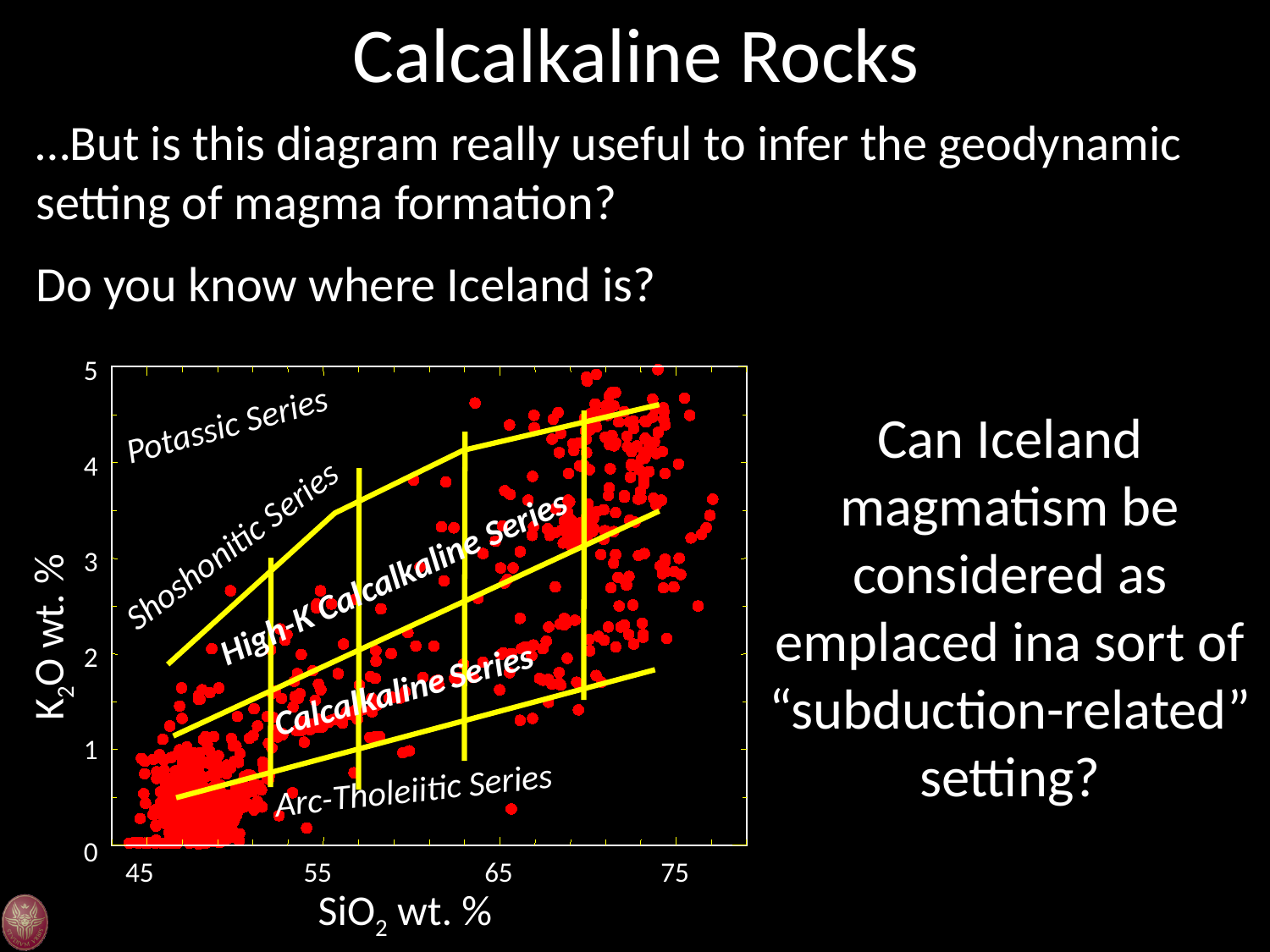
How many named series fields are labelled on the chart? 5 What is the label of the x axis of the chart? SiO2 wt. % Which labelled series field occupies the highest K2O region of the chart? Potassic Series Which labelled series field occupies the lowest K2O region of the chart? Arc-Tholeiitic Series Are there more data points plotted at SiO2 below 55 or at SiO2 between 60 and 65? below 55 What is the label of the y axis of the chart? K2O wt. % What kind of chart is shown on the slide? scatter plot Which series field lies between the High-K Calcalkaline Series and the Arc-Tholeiitic Series? Calcalkaline Series Do the yellow boundary lines rise or fall as SiO2 increases along the x axis? rise Is the K2O value of the dense cluster of points near SiO2 45–50 greater or less than 1? less